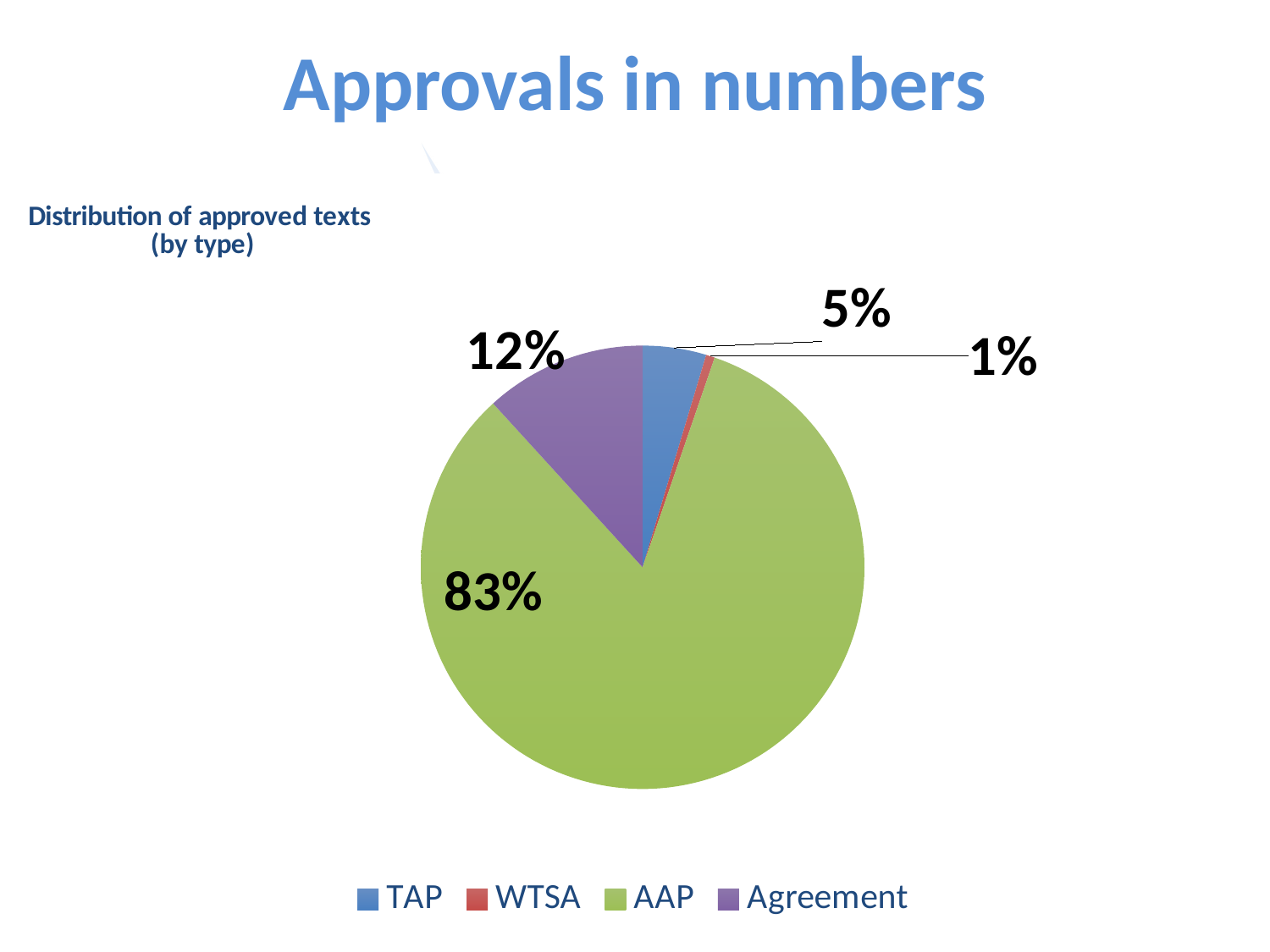
Which type has the largest share of approved texts? AAP What share of approved texts is TAP? 5% Which type has the smallest share of approved texts? WTSA What is the difference in percentage points between the AAP share and the Agreement share? 71 What kind of chart is shown on the slide? Pie chart How many types are shown in the pie chart? 4 What share of approved texts is AAP? 83% What share of approved texts is WTSA? 1% Which has a larger share, TAP or Agreement? Agreement What is the title of the chart? Distribution of approved texts (by type) Which colour represents AAP in the pie chart? Green What share of approved texts is Agreement? 12%